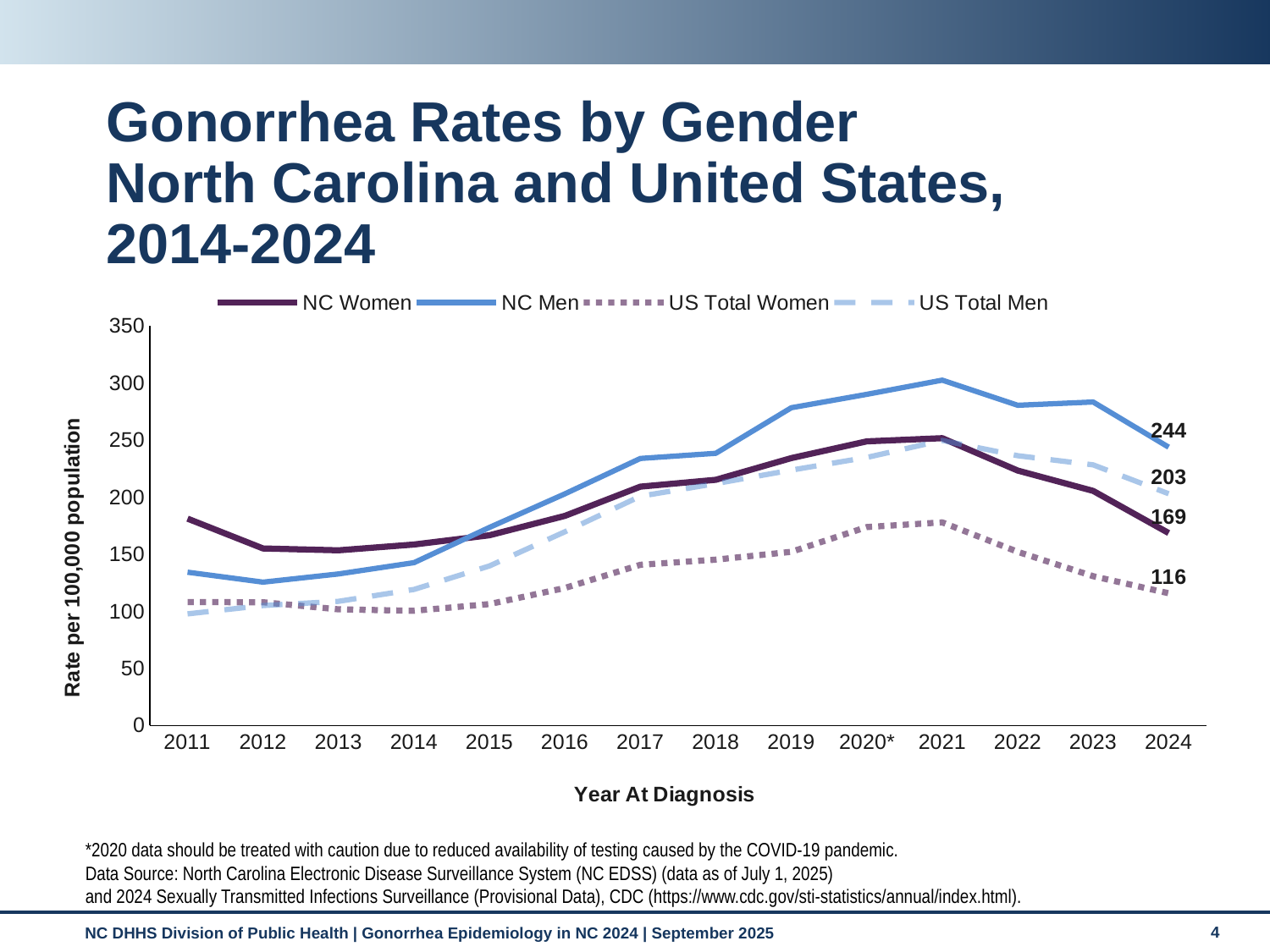
What type of chart is shown on the slide? line chart What is the NC Men gonorrhea rate in 2024? 244 What is the NC Women gonorrhea rate in 2024? 169 Is the NC Men value in 2021 greater or less than 250? greater What is the US Total Women rate in 2024? 116 What is the US Total Men rate in 2024? 203 In 2024, which is larger: the US Total Men rate or the NC Women rate? US Total Men How many years are shown on the x axis? 14 Which series has the highest value in 2024? NC Men Which series has the lowest value in 2024? US Total Women What is the difference between the NC Men and NC Women rates in 2024? 75 How many series does the legend list? 4